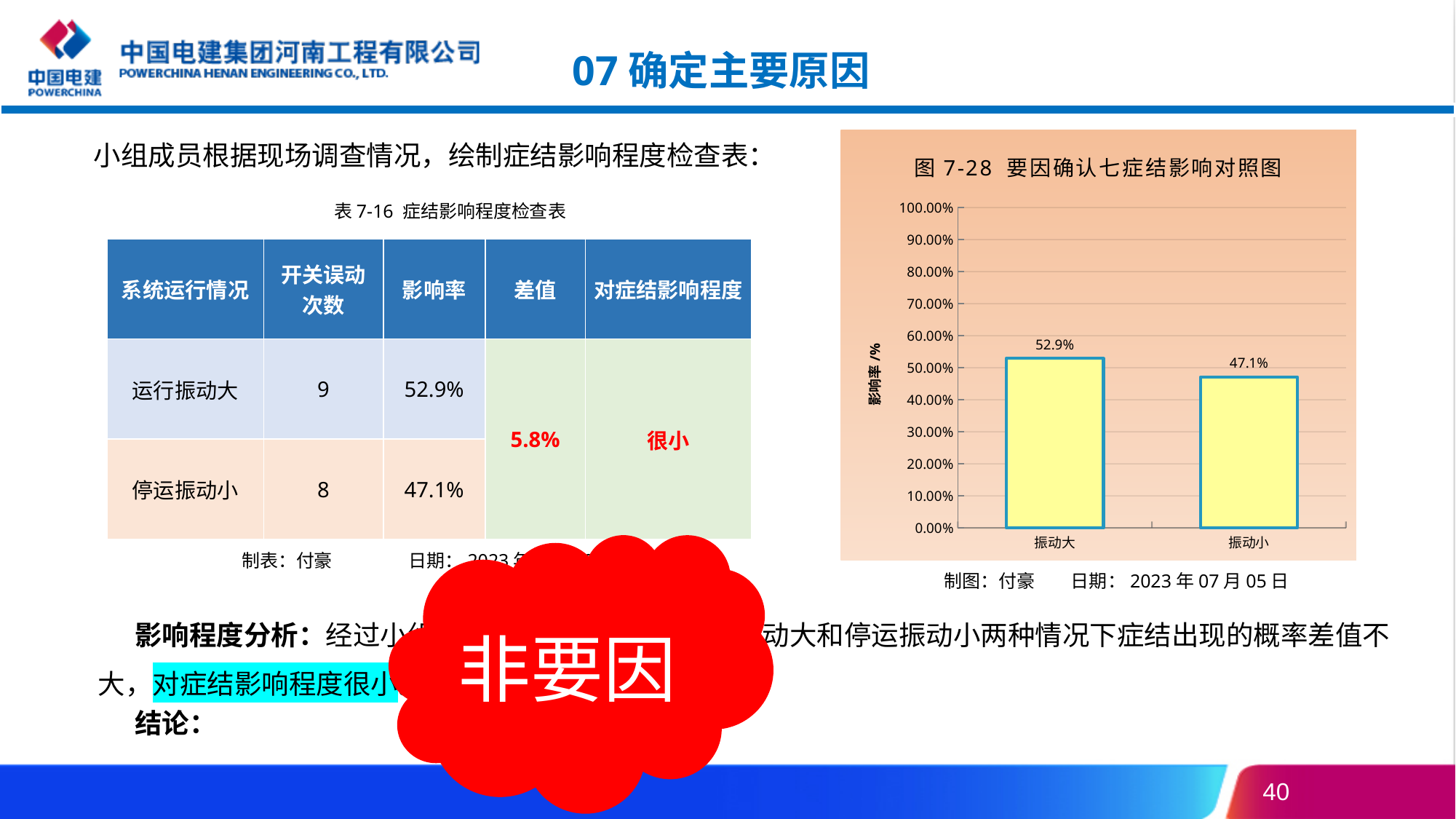
Which category has the lowest value in the chart? 振动小 Is the value for 振动大 greater or less than 50.00%? greater Is the value for 振动小 greater or less than 50.00%? less What is the value for 振动小 in the chart? 47.1% What is the difference between the values for 振动大 and 振动小? 5.8% Which is larger, the value for 振动大 or the value for 振动小? 振动大 What kind of chart is shown on the slide? bar chart What is the title of the chart? 图 7-28 要因确认七症结影响对照图 What is the label of the y axis of the chart? 影响率 /% Which category has the highest value in the chart? 振动大 How many categories are shown on the x axis of the chart? 2 What is the value for 振动大 in the chart? 52.9%